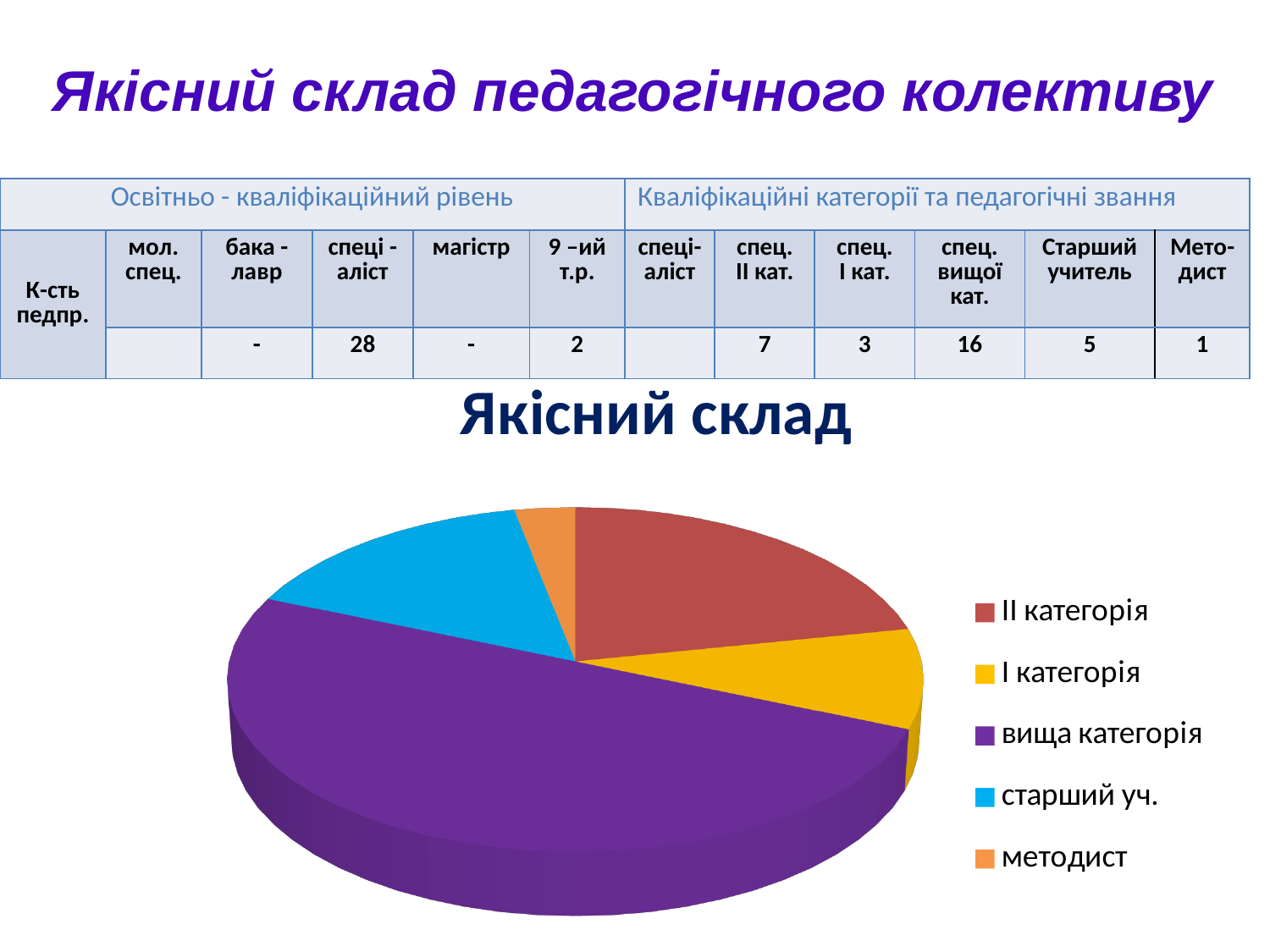
In the "Якісний склад" pie chart, which slice is larger: "старший уч." or "методист"? старший уч. In the "Якісний склад" pie chart, which slice is larger: "I категорія" or "методист"? I категорія How many entries does the legend of the "Якісний склад" pie chart list? 5 What kind of chart is shown under the heading "Якісний склад"? pie chart What colour is the "вища категорія" slice in the "Якісний склад" pie chart? purple Which category has the largest slice in the "Якісний склад" pie chart? вища категорія In the "Якісний склад" pie chart, which slice is larger: "II категорія" or "старший уч."? II категорія How many slices does the "Якісний склад" pie chart have? 5 What is the title of the pie chart on the slide? Якісний склад Which category has the smallest slice in the "Якісний склад" pie chart? методист